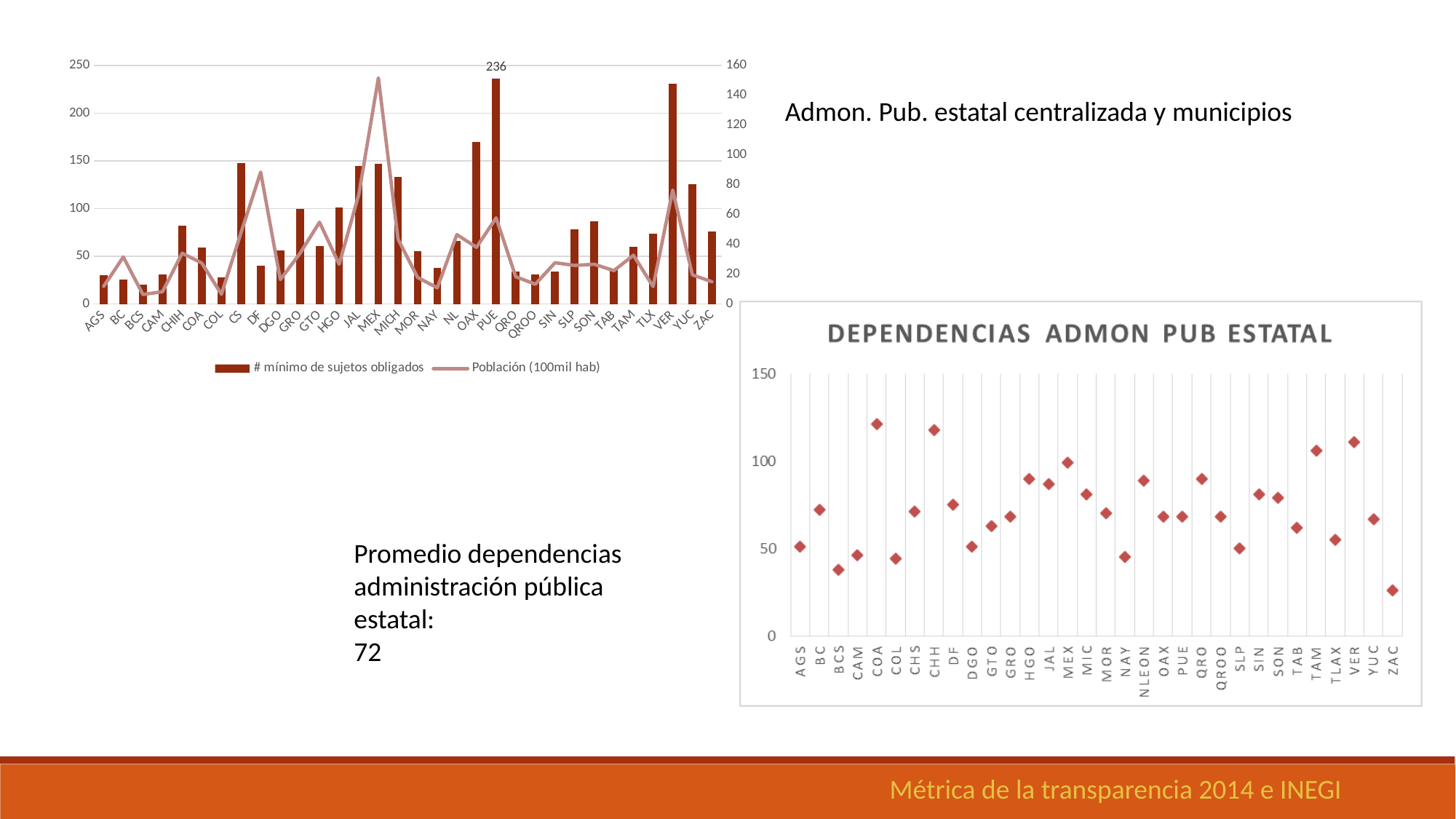
In the top-left chart, which state has the tallest bar for '# mínimo de sujetos obligados'? PUE In the top-left chart, is the '# mínimo de sujetos obligados' bar for BCS greater or less than 50? less In the top-left chart, which state has the highest point on the 'Población (100mil hab)' line? MEX In the 'DEPENDENCIAS ADMON PUB ESTATAL' chart, which state has the lowest value? ZAC In the top-left chart, which has a taller '# mínimo de sujetos obligados' bar, OAX or MICH? OAX How many series does the legend of the top-left chart list? 2 What is the title of the chart on the bottom right? DEPENDENCIAS ADMON PUB ESTATAL What kind of chart is 'DEPENDENCIAS ADMON PUB ESTATAL'? scatter chart How many states are shown on the x axis of the top-left chart? 32 In the 'DEPENDENCIAS ADMON PUB ESTATAL' chart, is the value for COA greater or less than 100? greater In the top-left chart, is the '# mínimo de sujetos obligados' bar for VER greater or less than 200? greater In the top-left chart, what is the value of '# mínimo de sujetos obligados' for PUE? 236